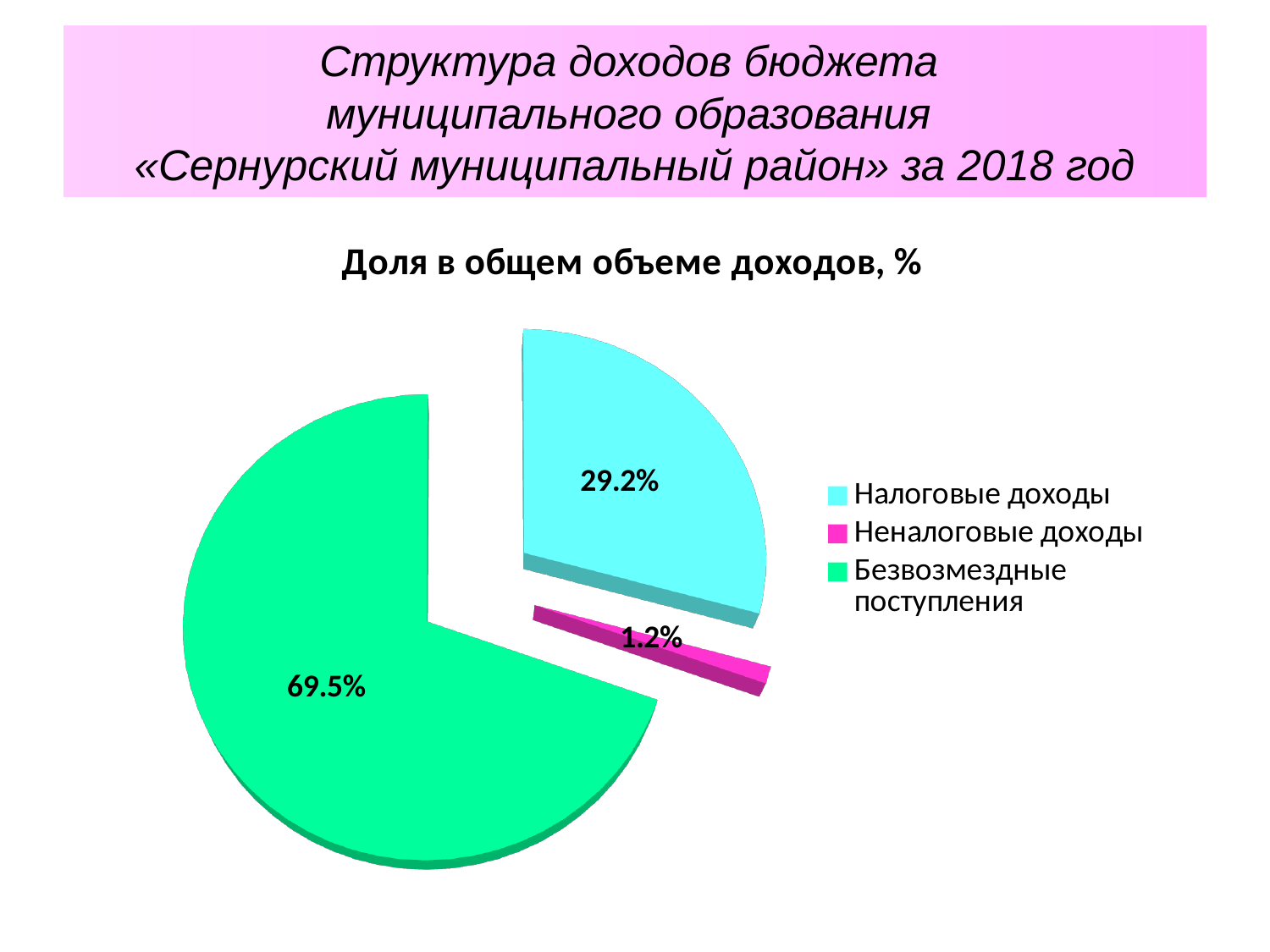
What type of chart is shown on the slide? Pie chart Which is larger: the share of Налоговые доходы or the share of Неналоговые доходы? Налоговые доходы What colour is the slice for Безвозмездные поступления? Green How many entries does the legend list? 3 What share does Налоговые доходы have in the pie? 29.2% What share does Неналоговые доходы have in the pie? 1.2% Which category has the smallest share of the pie? Неналоговые доходы How many categories does the pie chart have? 3 Which category has the largest share of the pie? Безвозмездные поступления What share does Безвозмездные поступления have in the pie? 69.5% What is the title of the chart? Доля в общем объеме доходов, % What is the difference between the shares of Безвозмездные поступления and Налоговые доходы? 40.3%